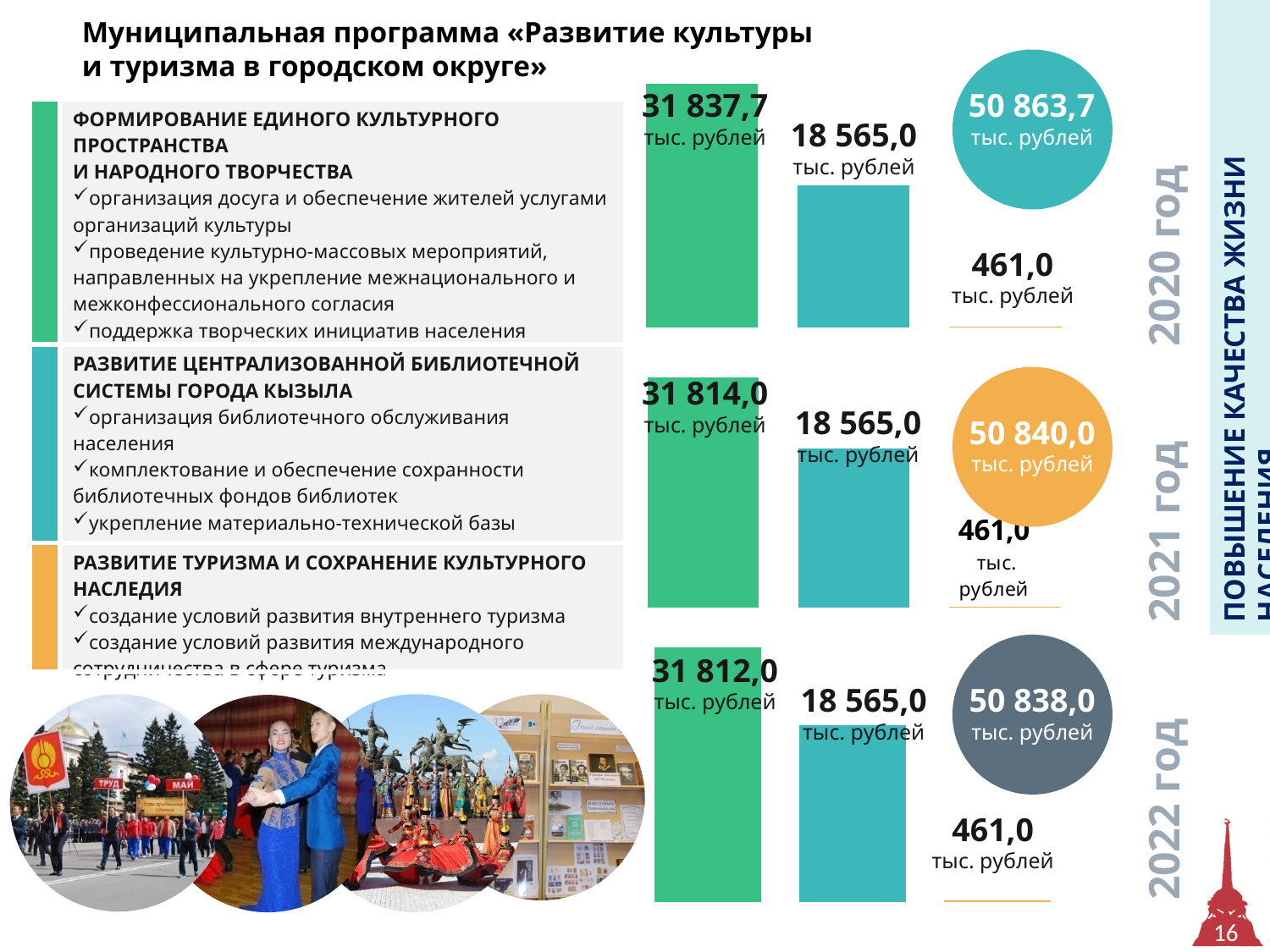
On the 2022 chart, what is the value of the smallest bar? 461,0 тыс. рублей On the 2020 chart, what is the value of the tallest (green) bar? 31 837,7 тыс. рублей What total is shown in the circle next to the 2022 chart? 50 838,0 тыс. рублей On the 2020 chart, which bar has the lowest value? the orange one (461,0 тыс. рублей) What is the total of the three values on the 2021 chart (31 814,0 + 18 565,0 + 461,0)? 50 840,0 тыс. рублей On the 2020 chart, what is the difference between the green bar (31 837,7) and the teal bar (18 565,0)? 13 272,7 тыс. рублей How many bars are shown on each year's chart? 3 Which is larger: the green bar on the 2020 chart or the green bar on the 2022 chart? the green bar on the 2020 chart (31 837,7) On the 2022 chart, which bar is the highest: the green one, the teal one, or the orange one? the green one What kind of chart is used to show the funding for each year? bar chart On the 2021 chart, what is the value of the second (teal) bar? 18 565,0 тыс. рублей How does the value of the green bar change from 2020 to 2022? it falls (31 837,7 → 31 814,0 → 31 812,0)